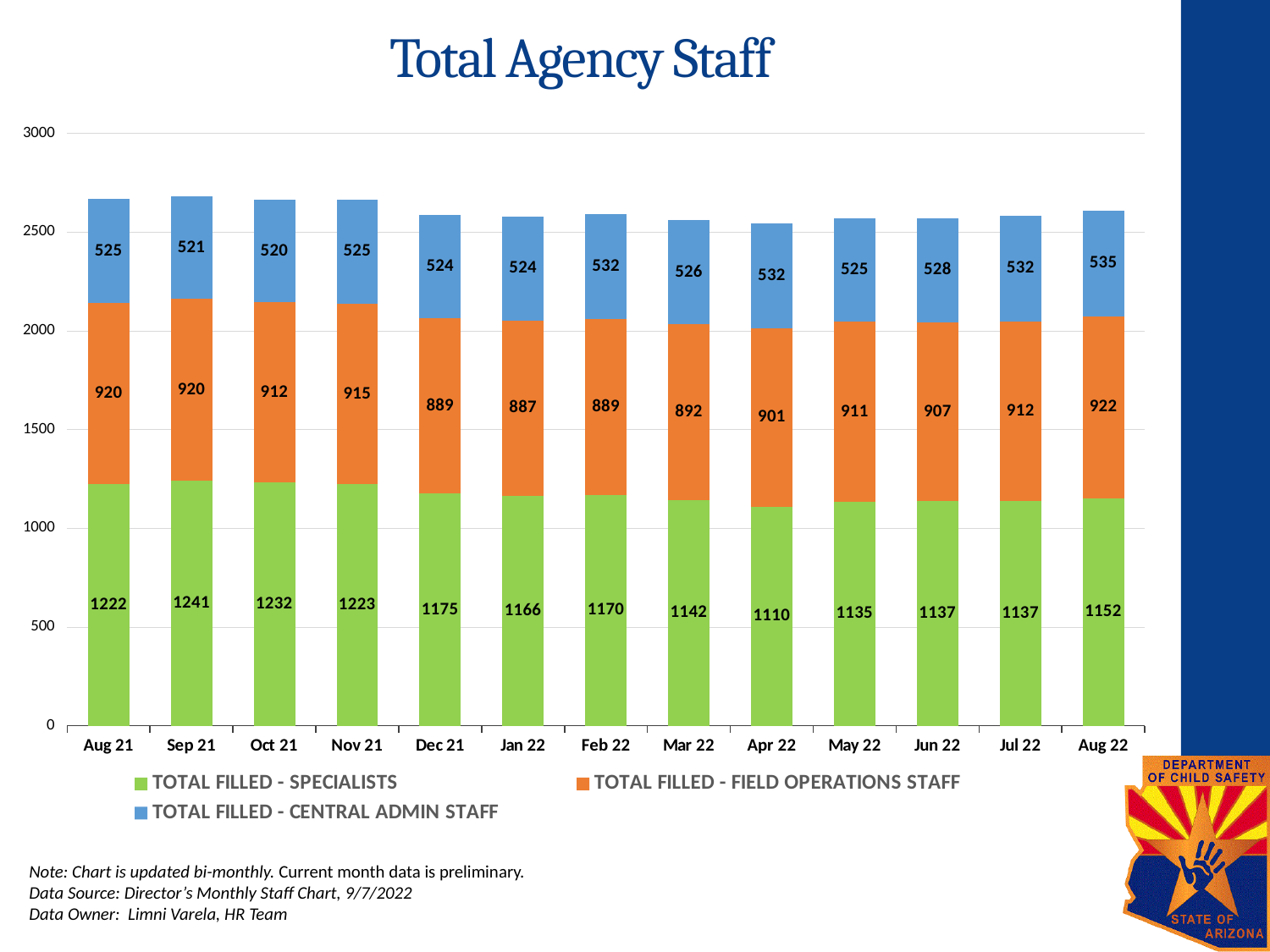
What is the difference between the TOTAL FILLED - SPECIALISTS values for Sep 21 and Apr 22? 131 Which month has the lowest value for TOTAL FILLED - FIELD OPERATIONS STAFF? Jan 22 What is the total of the stacked bar for Aug 21? 2667 What is the value for TOTAL FILLED - SPECIALISTS in Sep 21? 1241 What kind of chart is shown on the slide? Stacked bar chart Which is larger, the TOTAL FILLED - FIELD OPERATIONS STAFF value for Aug 22 or for Dec 21? Aug 22 Which month has the highest value for TOTAL FILLED - SPECIALISTS? Sep 21 What is the value for TOTAL FILLED - FIELD OPERATIONS STAFF in Apr 22? 901 Which month has the lowest value for TOTAL FILLED - SPECIALISTS? Apr 22 How many series does the legend list? 3 How many months are shown on the x axis? 13 What is the value for TOTAL FILLED - CENTRAL ADMIN STAFF in Aug 22? 535